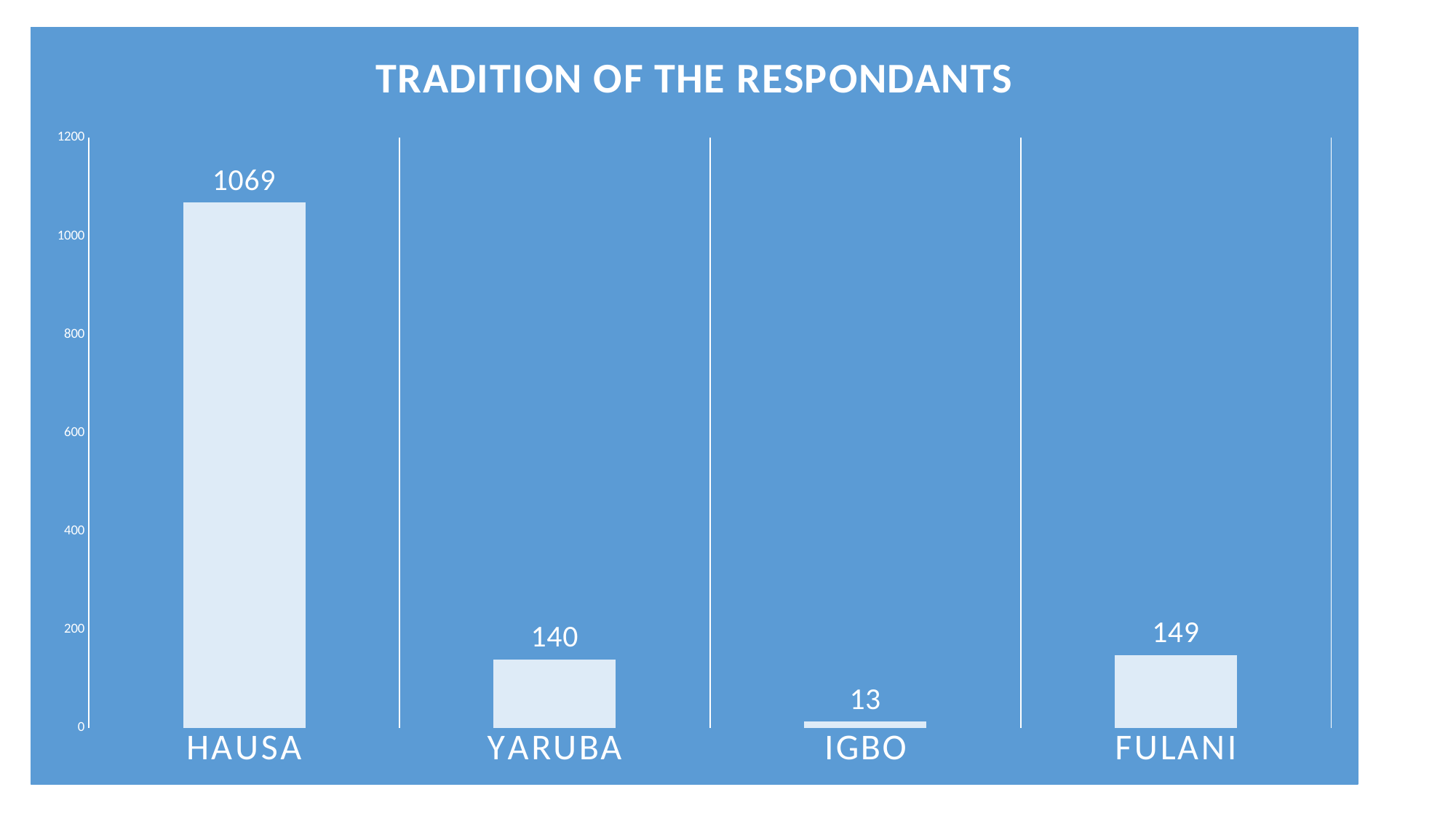
What is the value for IGBO? 13 What is the difference between the values for HAUSA and FULANI? 920 Which is larger, the value for YARUBA or the value for IGBO? YARUBA Which category has the highest value? HAUSA What is the value for FULANI? 149 What is the value for YARUBA? 140 What is the value for HAUSA? 1069 Is the value for HAUSA greater or less than 1000? greater What is the difference between the values for FULANI and YARUBA? 9 What kind of chart is shown on the slide? bar chart Which category has the lowest value? IGBO How many categories are shown on the x axis? 4